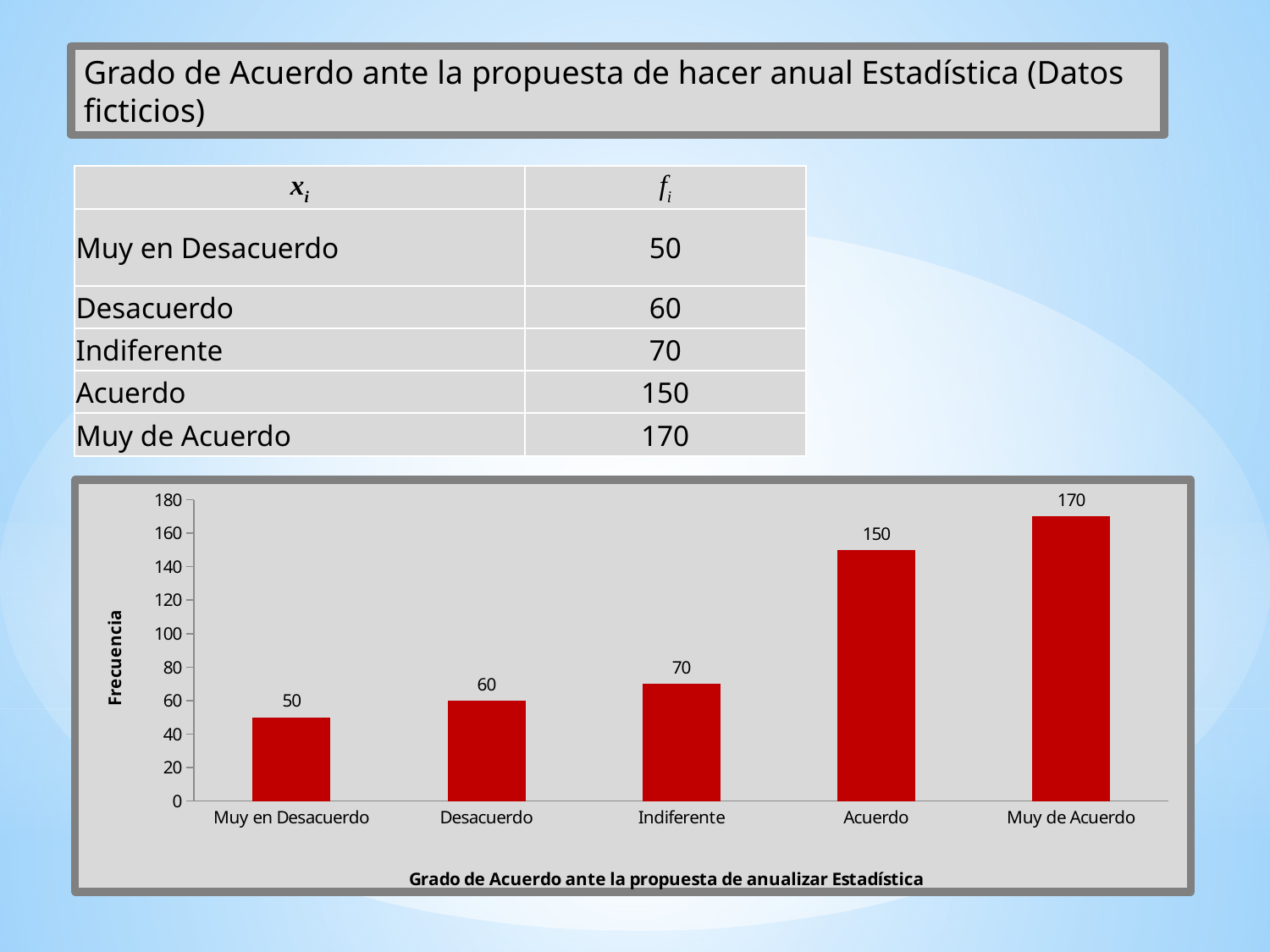
What is the value for Muy en Desacuerdo in the chart? 50 What kind of chart is shown on the slide? Bar chart What is the difference between the values for Muy de Acuerdo and Acuerdo? 20 What is the value for Acuerdo in the chart? 150 Which category has the lowest value in the chart? Muy en Desacuerdo What is the difference between the values for Acuerdo and Indiferente? 80 Is the value for Acuerdo greater or less than 140? greater Which is larger, the value for Desacuerdo or the value for Indiferente? Indiferente Do the values rise or fall from left to right along the x axis? Rise How many categories are shown on the x axis of the chart? 5 What is the value for Indiferente in the chart? 70 Which category has the highest value in the chart? Muy de Acuerdo